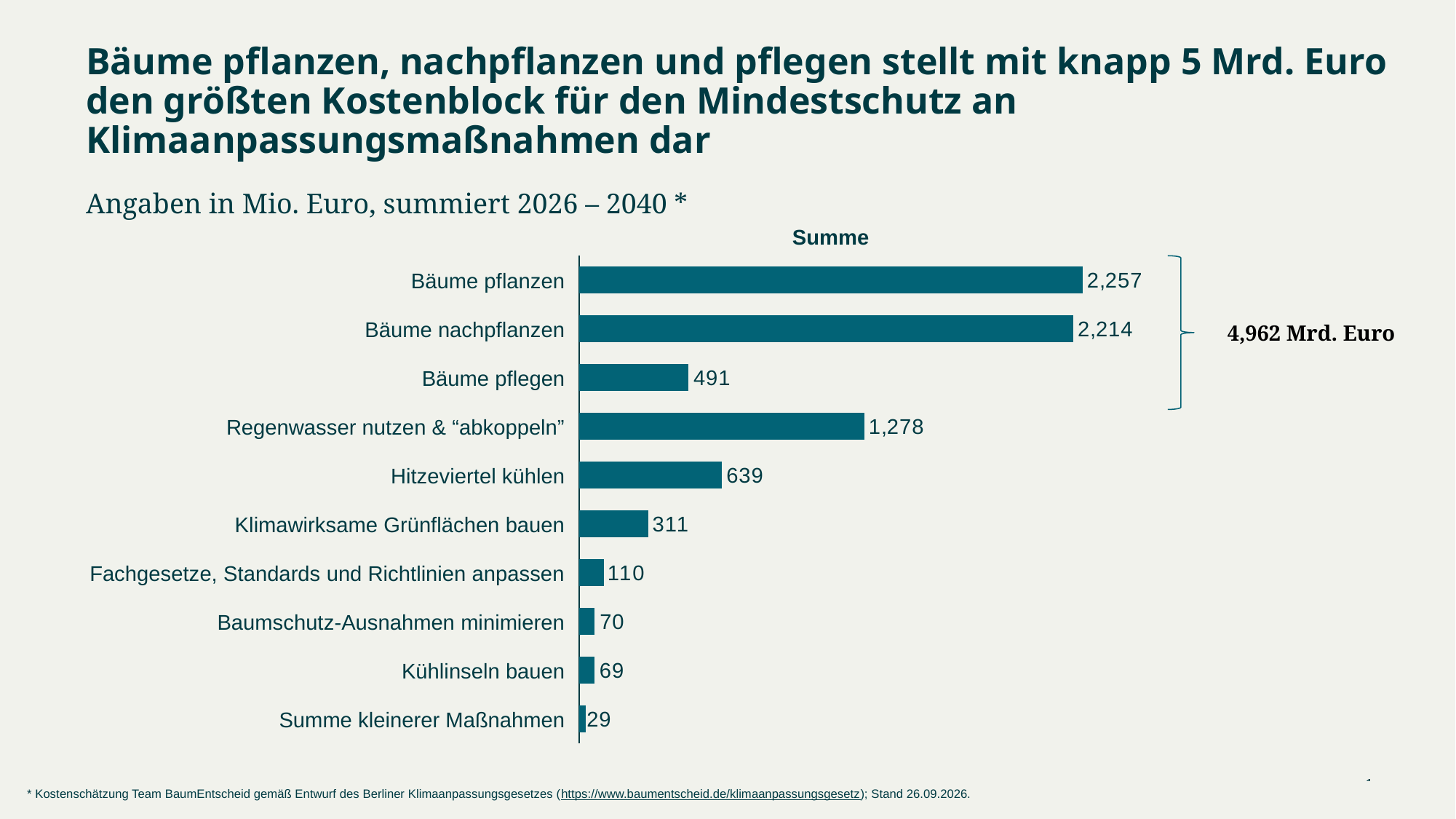
What total is shown by the bracket grouping the first three bars? 4,962 Mrd. Euro How many categories are shown in the chart? 10 Which category has the lowest value? Summe kleinerer Maßnahmen What is the value for Bäume pflanzen? 2,257 Which category has the highest value? Bäume pflanzen What is the difference between the values for Bäume pflanzen and Bäume nachpflanzen? 43 What is the value for Hitzeviertel kühlen? 639 Which is larger, the value for Bäume pflegen or the value for Hitzeviertel kühlen? Hitzeviertel kühlen What is the title shown above the chart? Summe What kind of chart is shown on the slide? Bar chart What is the value for Summe kleinerer Maßnahmen? 29 What is the value for Regenwasser nutzen & "abkoppeln"? 1,278